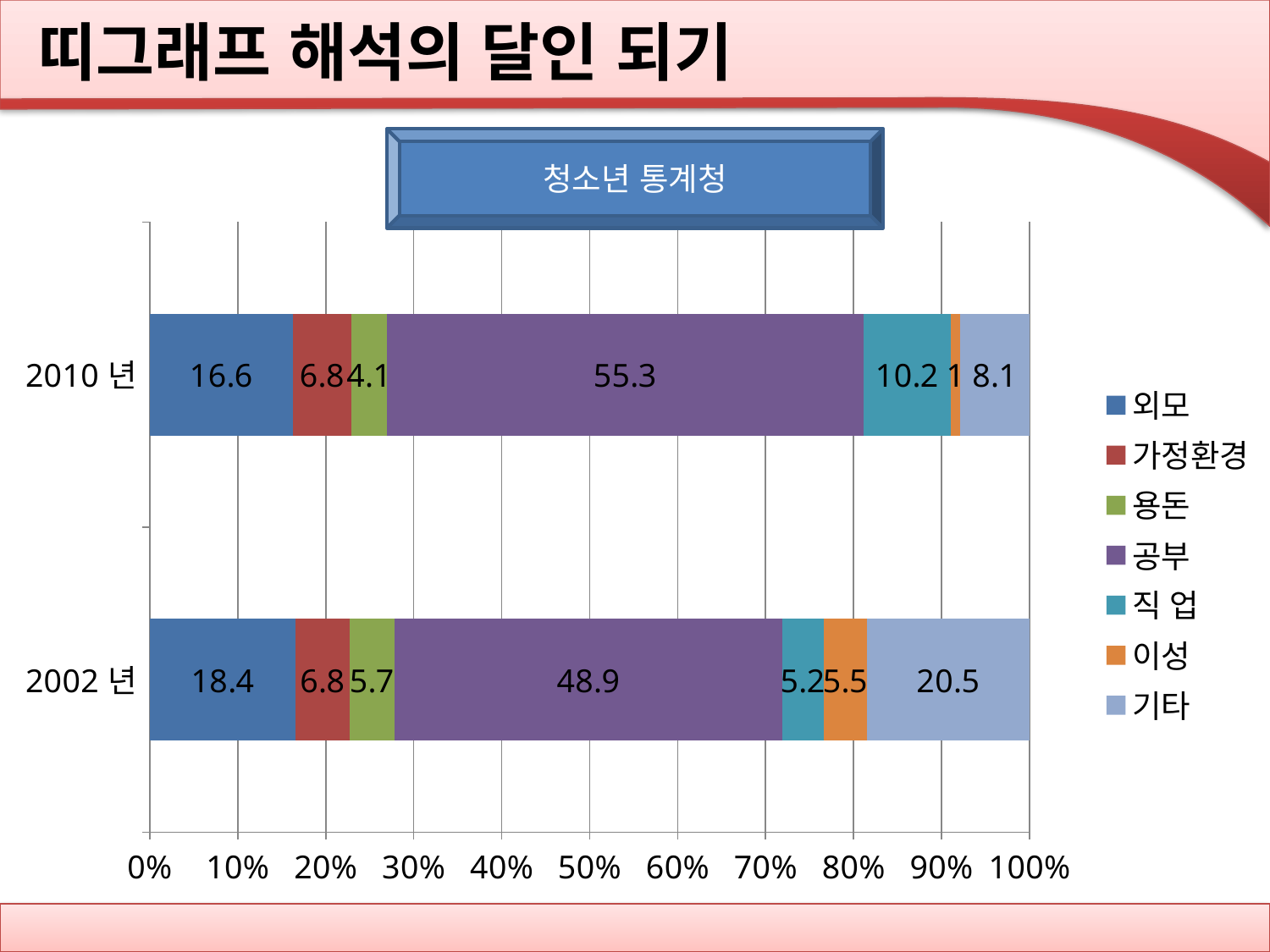
What kind of chart is shown on the slide? Stacked bar chart What is the value for 직 업 in 2010 년? 10.2 What is the difference between the 공부 values for 2010 년 and 2002 년? 6.4 What is the value for 기타 in 2002 년? 20.5 How many categories (years) are shown on the chart? 2 What is the difference between the 기타 values for 2002 년 and 2010 년? 12.4 How many series does the legend list? 7 Is the value for 외모 larger in 2010 년 or in 2002 년? 2002 년 What is the value for 외모 in 2010 년? 16.6 What is the value for 공부 in 2010 년? 55.3 Which series has the smallest segment in the 2010 년 bar? 이성 Which series has the largest segment in the 2002 년 bar? 공부